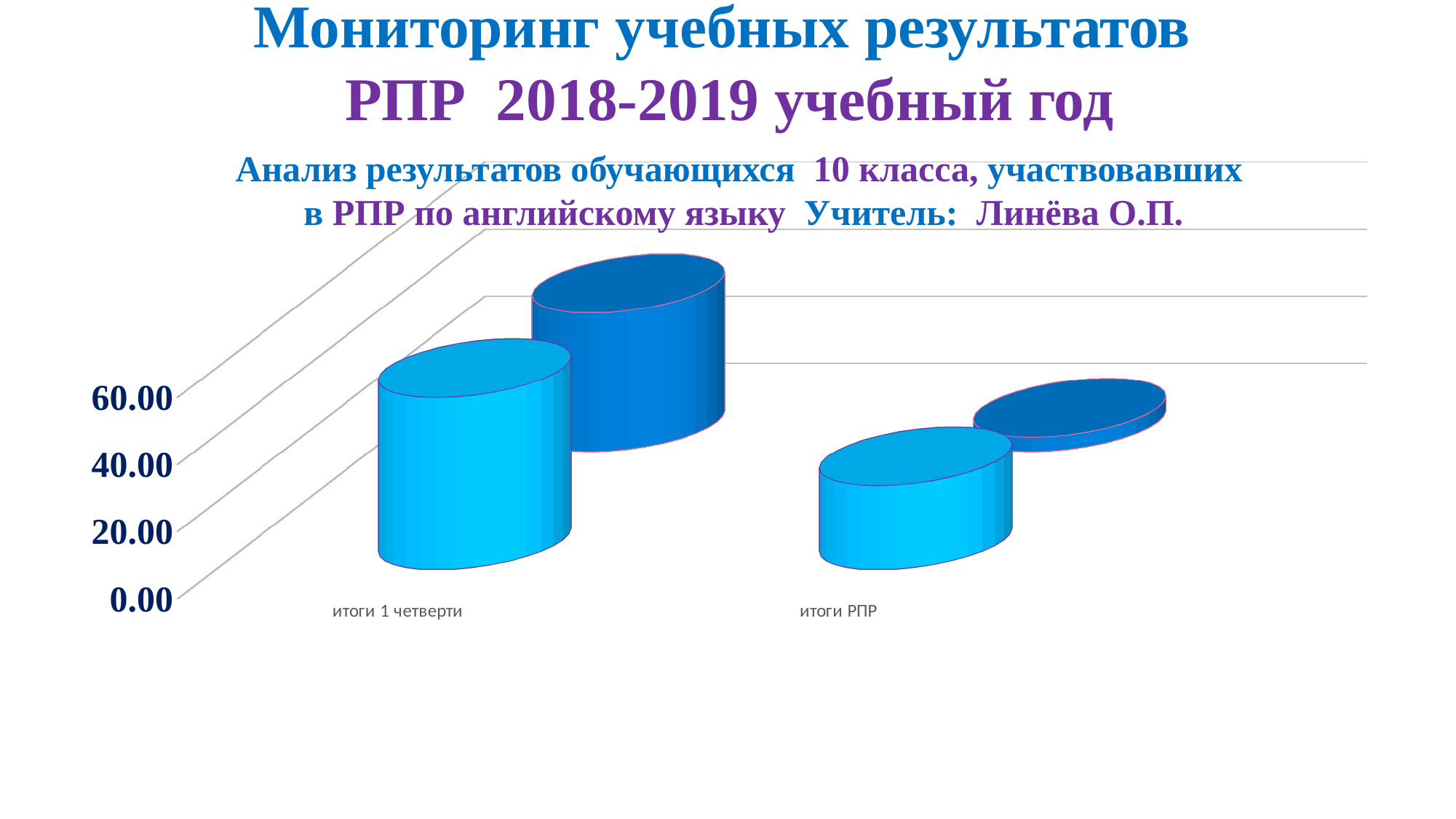
How many bars (cylinders) are plotted in the chart in total? 4 Do the values rise or fall from итоги 1 четверти to итоги РПР? fall Which category has the taller light blue bar: итоги 1 четверти or итоги РПР? итоги 1 четверти Which category has the taller dark blue bar: итоги 1 четверти or итоги РПР? итоги 1 четверти Is the value of the dark blue bar for итоги РПР greater or less than 20.00? less What kind of chart is shown on the slide? bar chart What are the two category labels on the x axis of the chart? итоги 1 четверти, итоги РПР For итоги РПР, which bar is taller: the light blue one or the dark blue one? the light blue one Which category has the lowest bar in the chart? итоги РПР What is the lowest value label shown on the vertical axis of the chart? 0.00 Is the value of the light blue bar for итоги 1 четверти greater or less than 40.00? greater How many categories are shown on the x axis of the chart? 2